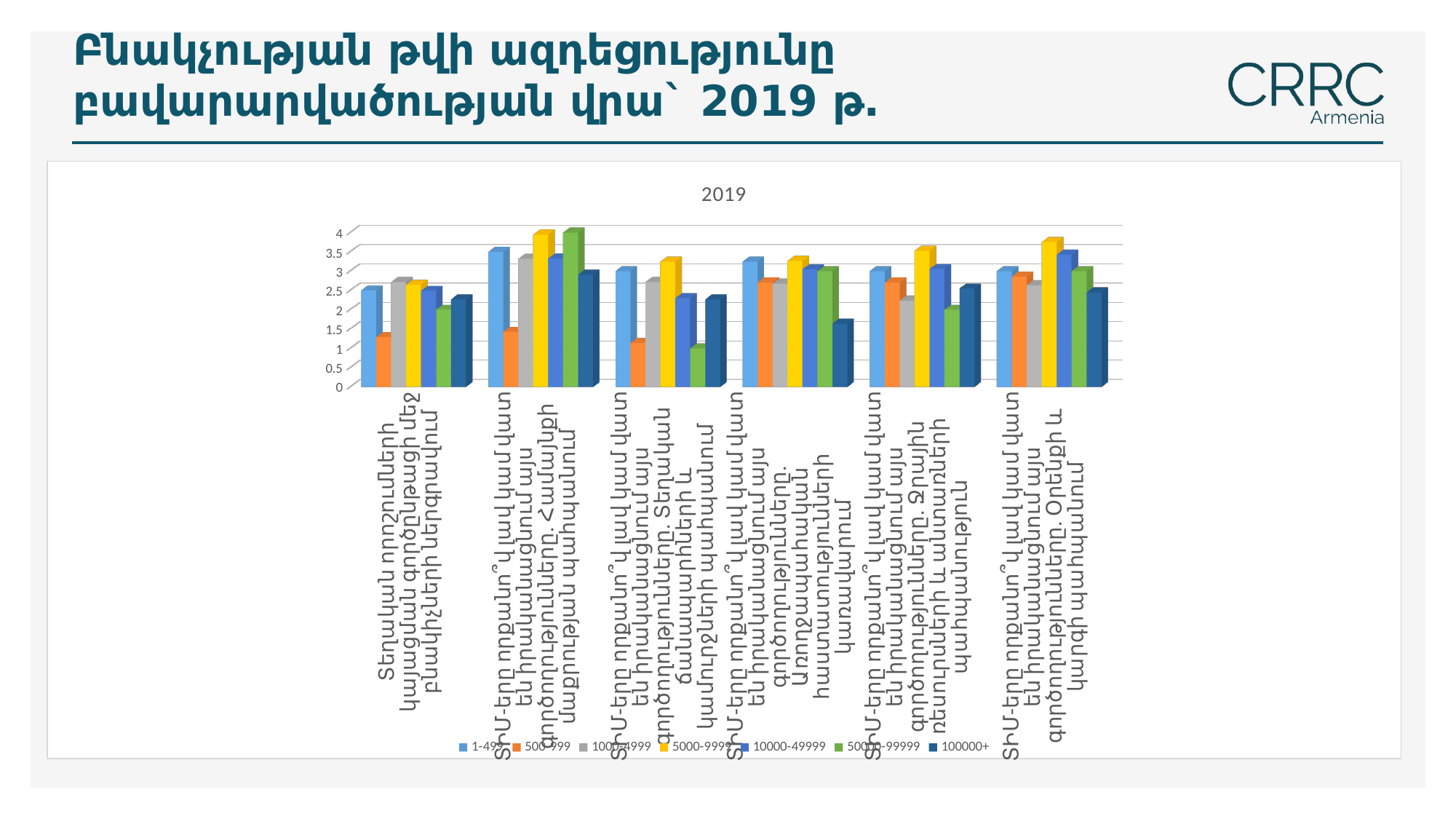
Which legend entry is shown in yellow? 5000-9999 In the second category from the left, is the value for the 5000-9999 series greater or less than 3.5? greater In the first (leftmost) category, is the value for the 500-999 series greater or less than 2? less In the third category from the left, is the value for the 50000-99999 series greater or less than 2? less In the third category from the left, which is larger: the value for 5000-9999 or the value for 50000-99999? 5000-9999 How many categories (groups of bars) are plotted along the x axis? 6 What is the title shown above the chart? 2019 In the first (leftmost) category, which is larger: the value for 1-499 or the value for 500-999? 1-499 What kind of chart is shown on the slide? bar chart How many series does the chart's legend list? 7 In the fourth category from the left, which series has the lowest value? 100000+